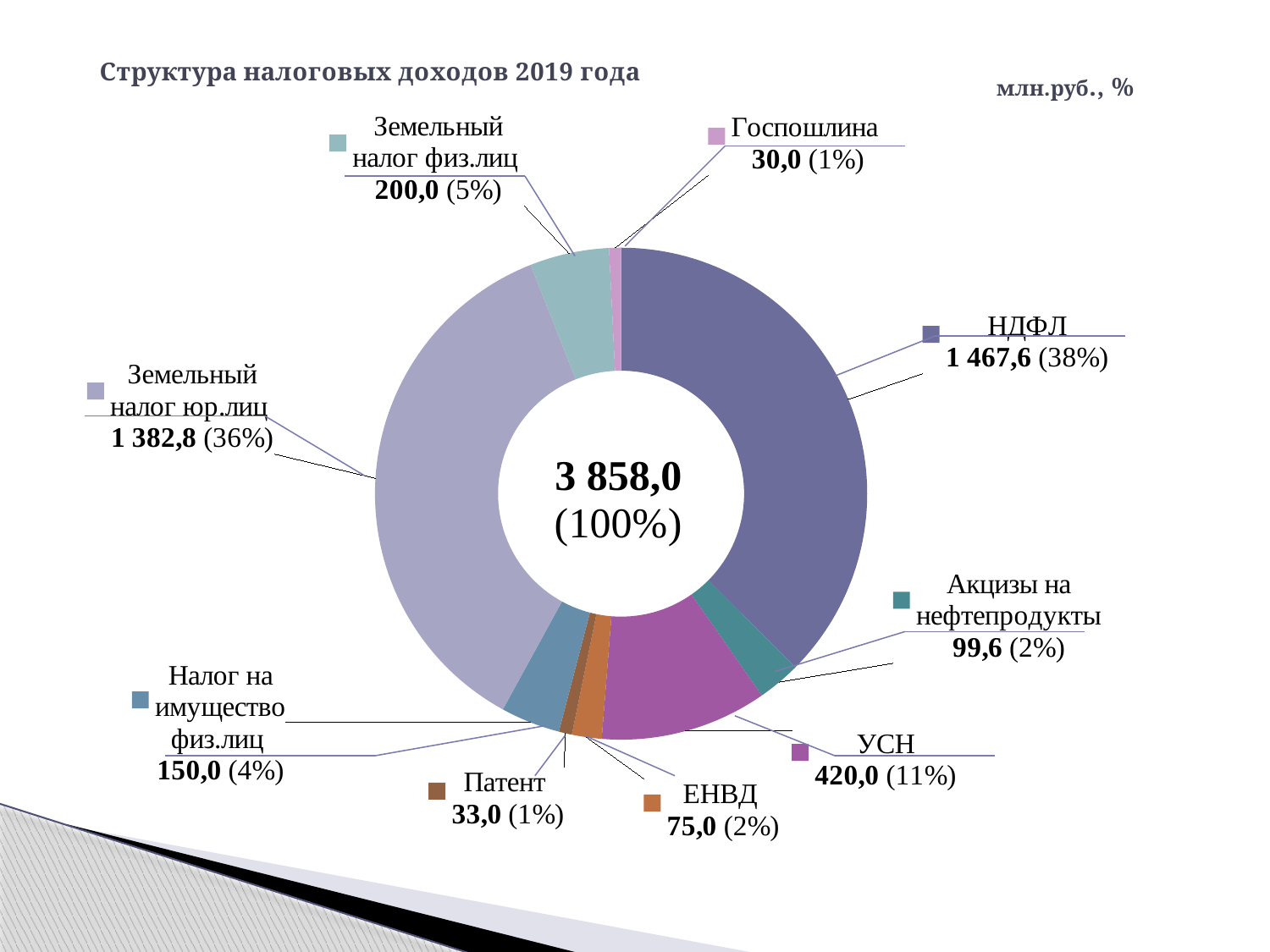
Which is larger, УСН or Налог на имущество физ.лиц? УСН What is the title of the chart? Структура налоговых доходов 2019 года What is the value for УСН? 420,0 What is the difference between НДФЛ and Земельный налог юр.лиц? 84,8 What is the value for НДФЛ? 1 467,6 What share of the total does Земельный налог юр.лиц represent? 36% How many categories are shown in the chart? 9 What is the total value shown in the centre of the chart? 3 858,0 Which category has the smallest value? Госпошлина Which category has the largest value? НДФЛ What is the value for Акцизы на нефтепродукты? 99,6 What type of chart is shown on the slide? Doughnut (pie) chart